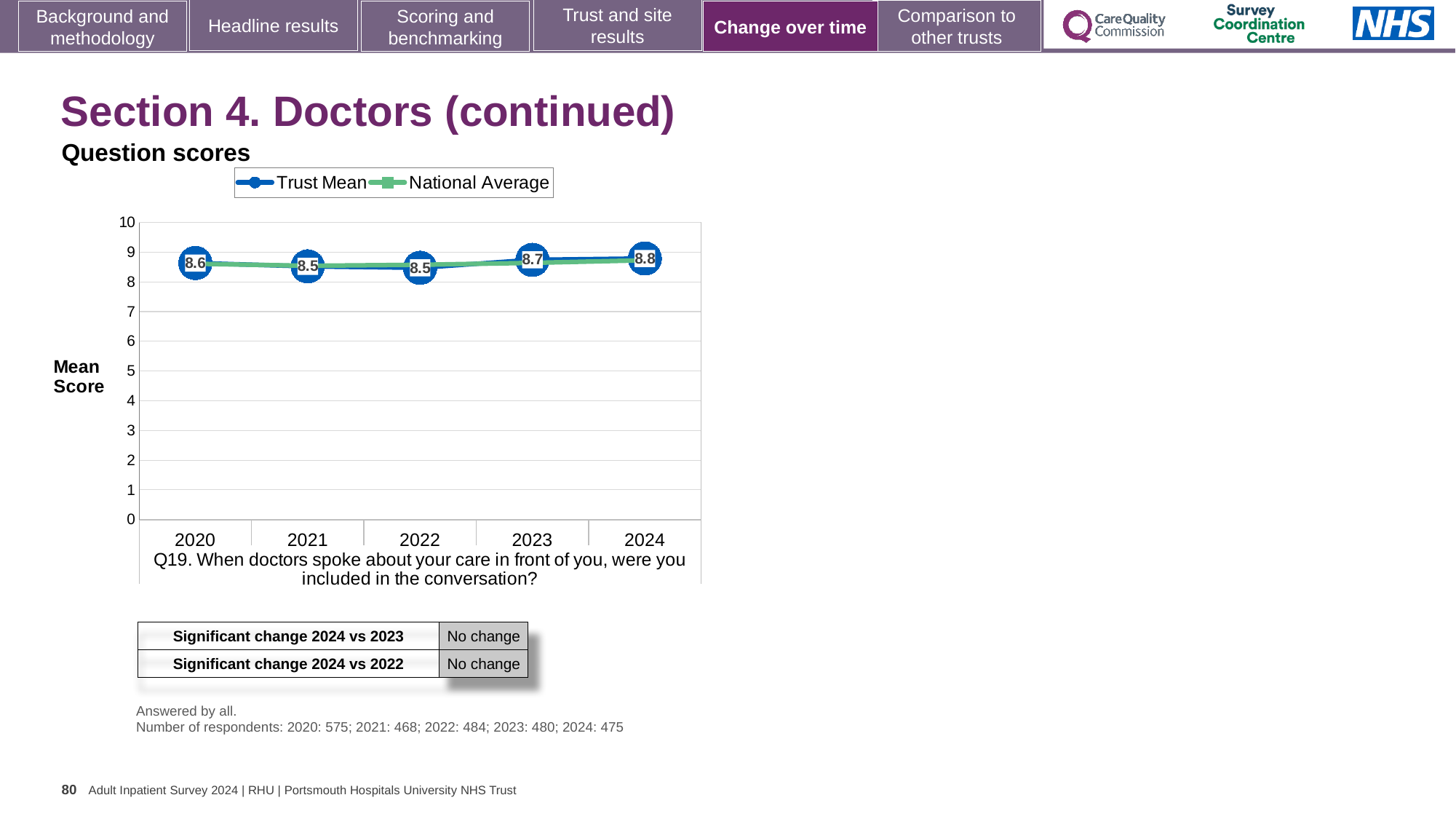
What is the Trust Mean score for 2024? 8.8 Between 2022 and 2024, does the Trust Mean score rise or fall? rise How many series does the chart legend list? 2 What is the difference between the Trust Mean score in 2024 and in 2020? 0.2 In which year is the Trust Mean score highest? 2024 What is the label on the y axis of the chart? Mean Score What is the Trust Mean score for 2020? 8.6 What is the Trust Mean score for 2023? 8.7 Which year has the larger Trust Mean score, 2021 or 2023? 2023 How many years are shown on the x axis of the chart? 5 Is the National Average value for 2020 greater or less than 8? greater What kind of chart is shown on the slide? line chart